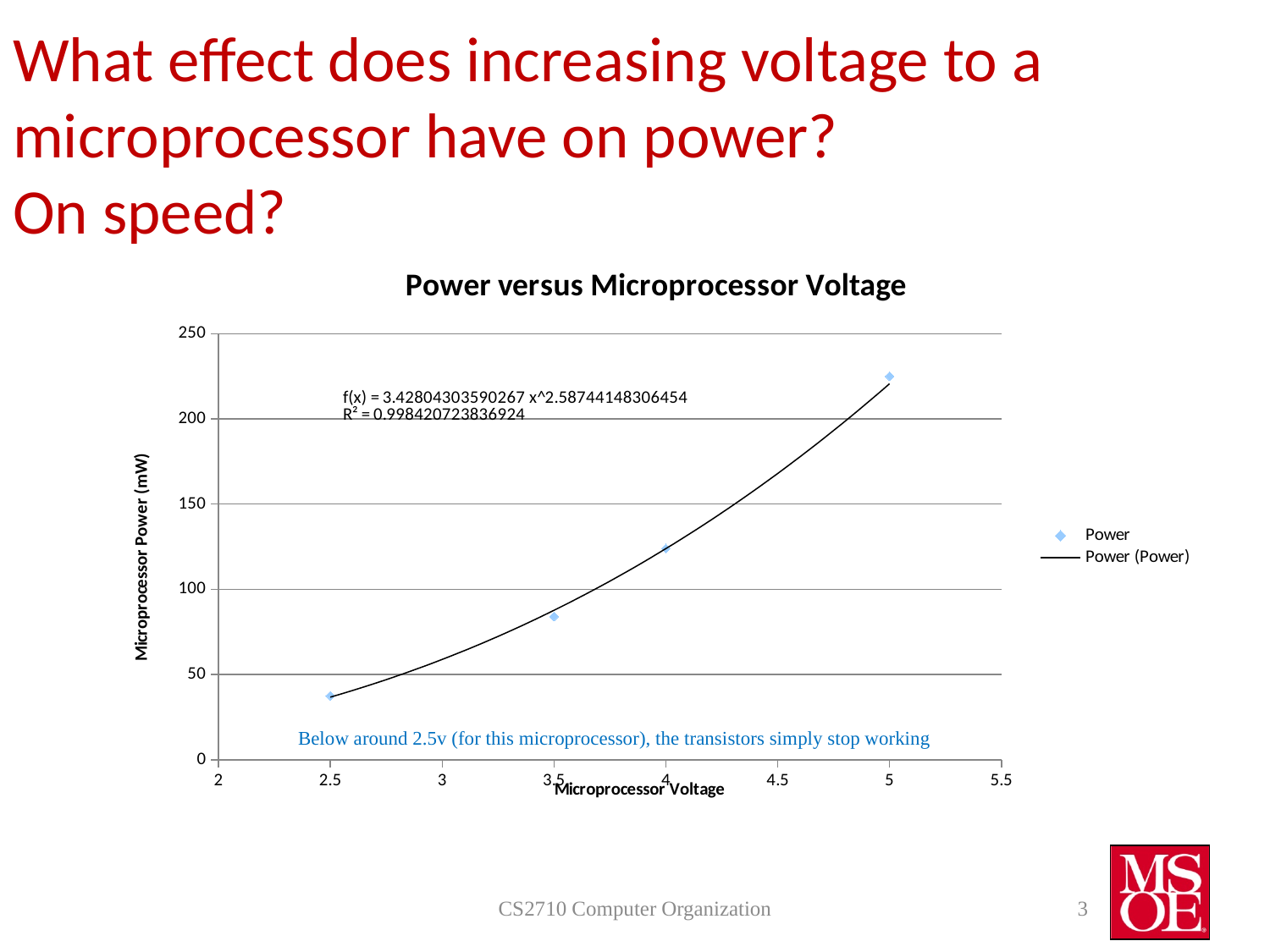
Is the power value at a voltage of 5 greater or less than 200? greater How many entries does the chart legend list? 2 How many data points are plotted in the chart? 4 What is the title of the chart? Power versus Microprocessor Voltage Which has the larger power value: the point at a voltage of 4 or the point at a voltage of 3.5? 4 At which microprocessor voltage is the plotted power lowest? 2.5 What type of chart is shown on the slide? Scatter chart Is the power value at a voltage of 3.5 greater or less than 100? less Does the microprocessor power rise or fall as the voltage increases along the x axis? Rise What is the label of the y axis? Microprocessor Power (mW) At which microprocessor voltage is the plotted power highest? 5 Is the power value at a voltage of 2.5 greater or less than 50? less